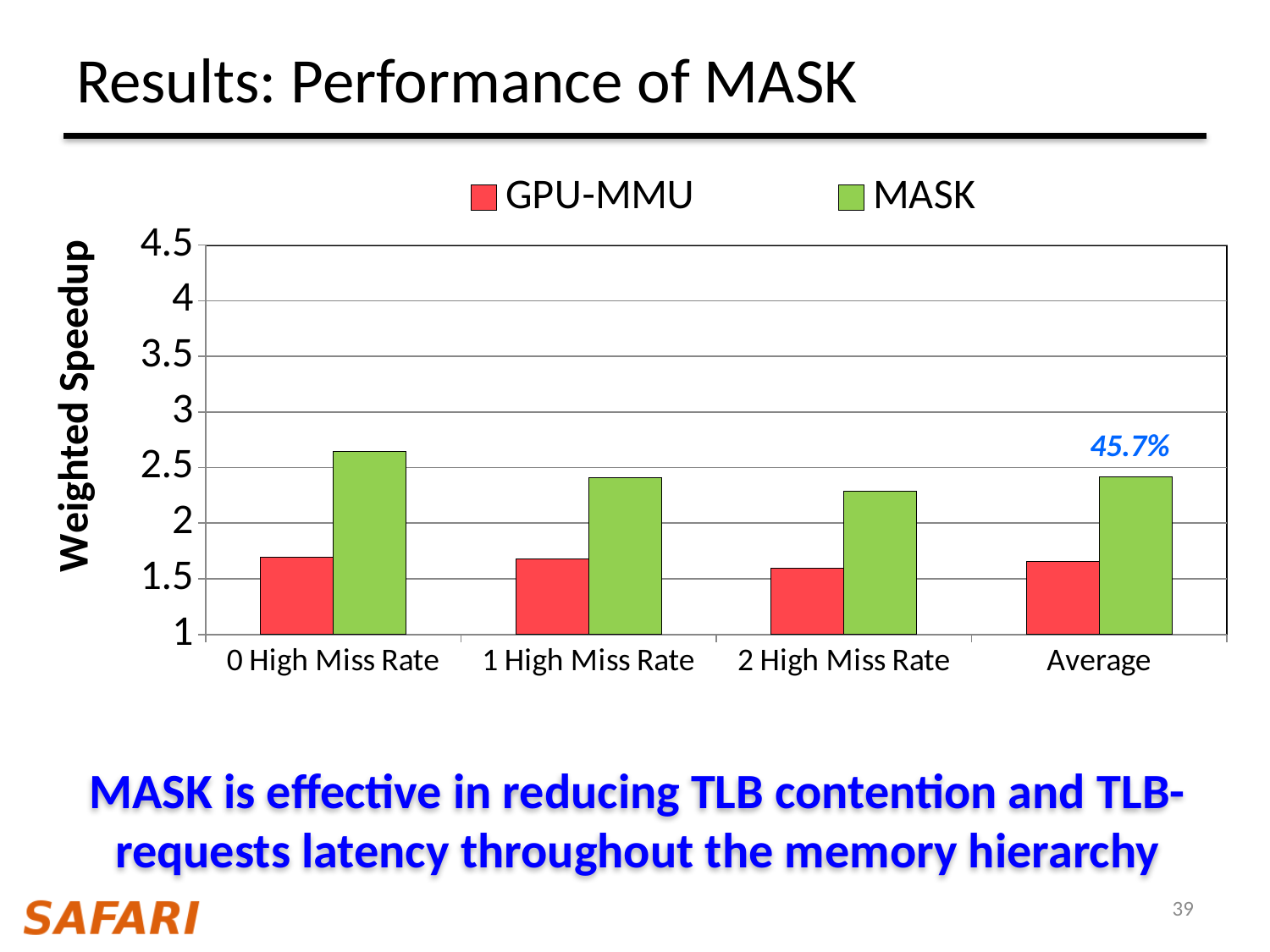
How many categories are shown on the x axis? 4 For the Average category, which series has the larger value, GPU-MMU or MASK? MASK Is the GPU-MMU value for 0 High Miss Rate greater or less than 2? less Is the MASK value for 0 High Miss Rate greater or less than 2.5? greater For which category is the MASK bar lowest? 2 High Miss Rate What kind of chart is shown on the slide? bar chart What percentage is printed above the MASK bar for the Average category? 45.7% For which category is the MASK bar highest? 0 High Miss Rate Is the MASK value for 2 High Miss Rate greater or less than 2? greater Do the MASK values rise or fall from 0 High Miss Rate to 2 High Miss Rate? fall What is the label on the y axis? Weighted Speedup How many series does the legend list? 2